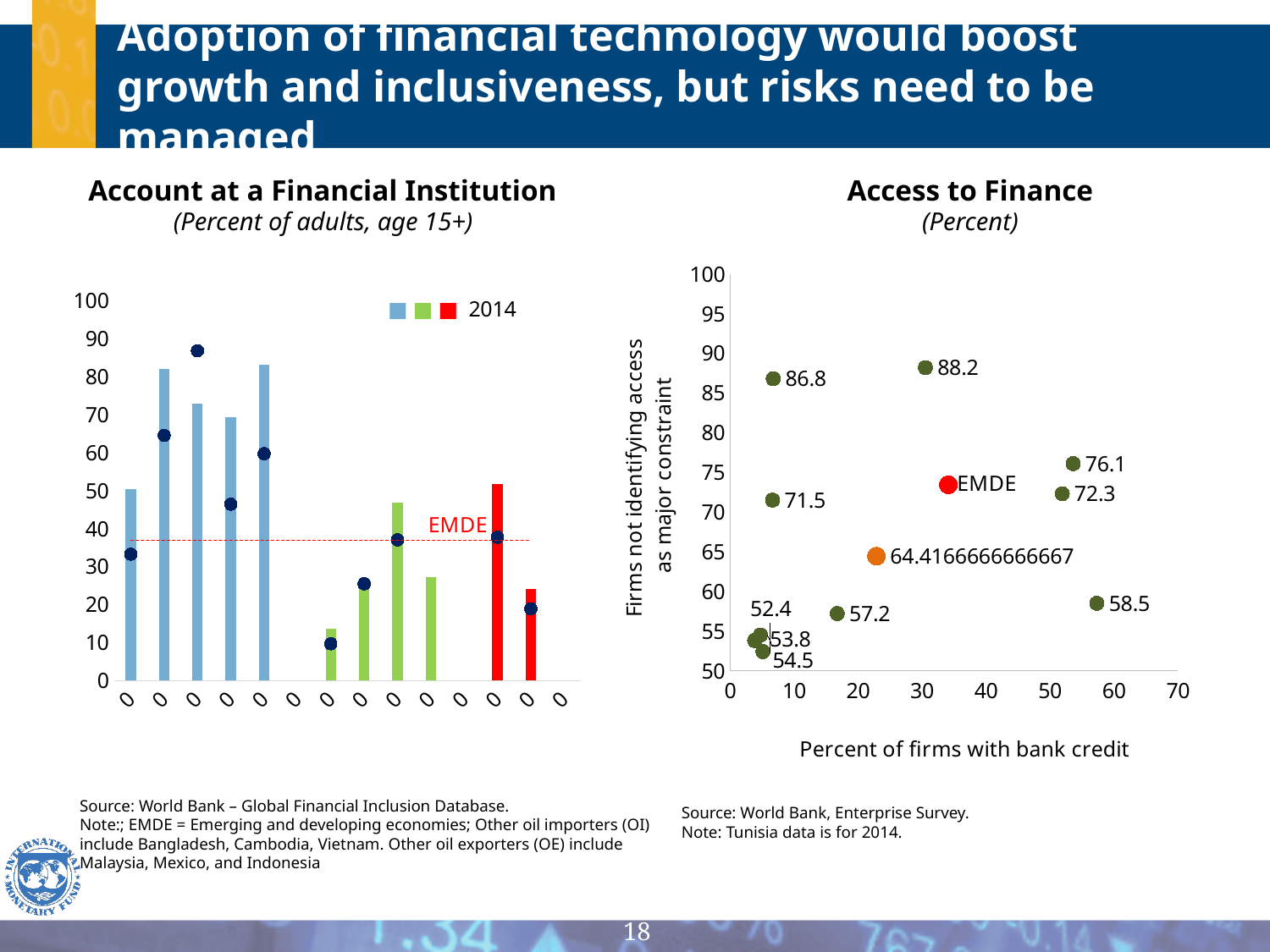
In the "Access to Finance" chart, is the vertical-axis value of the EMDE point greater or less than 70? greater In the "Access to Finance" chart, what is the highest labeled value? 88.2 In the "Access to Finance" chart, how many points are plotted? 12 In the "Account at a Financial Institution" chart, what year does the legend show? 2014 In the "Access to Finance" chart, what is the label of the horizontal axis? Percent of firms with bank credit What kind of chart is the "Access to Finance" chart on the right? scatter chart In the "Access to Finance" chart, which is larger: the point labeled 76.1 or the point labeled 72.3? 76.1 What kind of chart is the "Account at a Financial Institution" chart on the left? bar chart In the "Access to Finance" chart, what is the difference between the two highest labeled points, 88.2 and 86.8? 1.4 In the "Access to Finance" chart, what is the lowest labeled value? 52.4 In the "Access to Finance" chart, is the horizontal-axis value of the EMDE point greater or less than 30? greater In the "Access to Finance" chart, what is the value shown on the orange point? 64.4166666666667